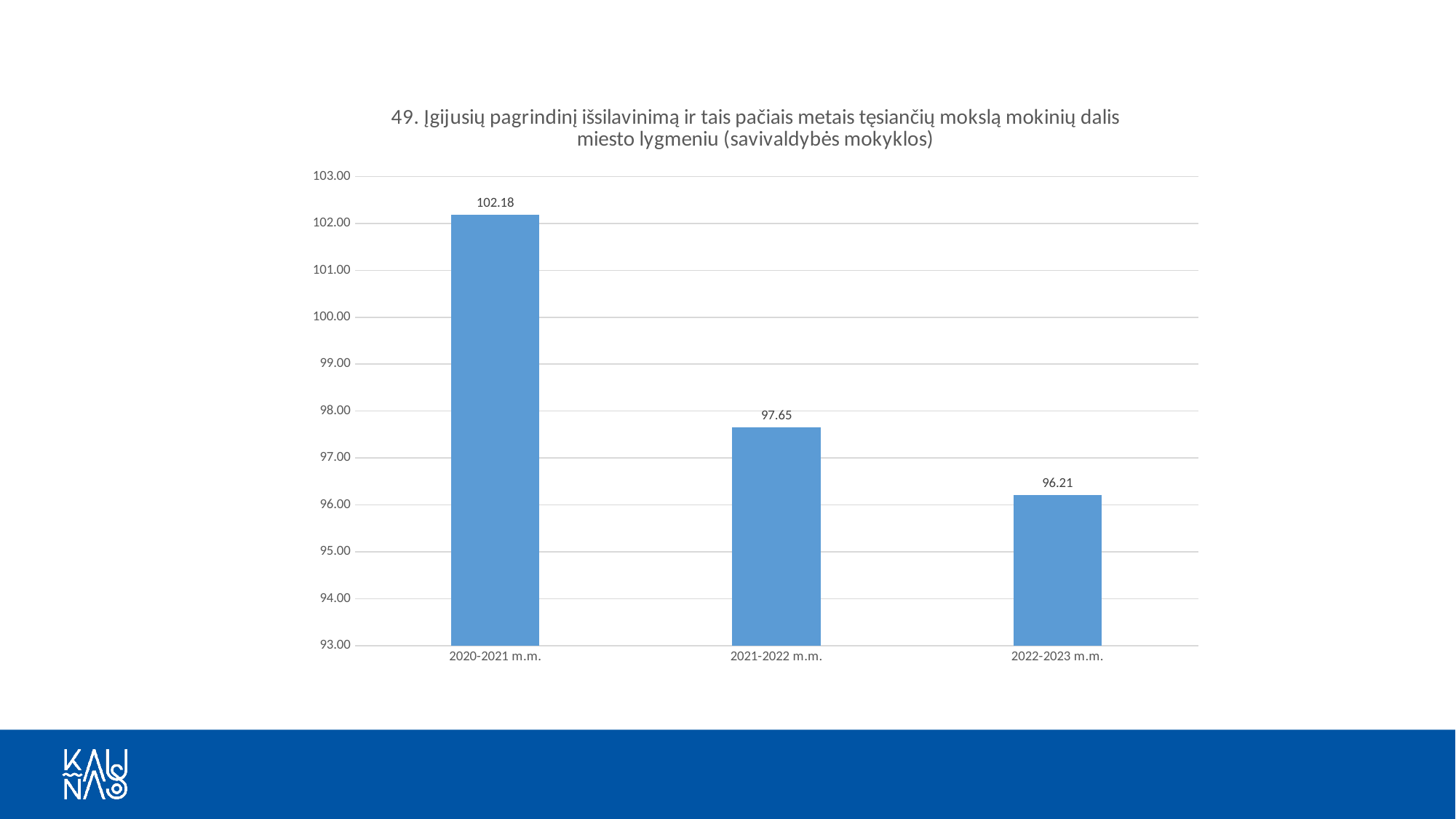
What is the difference between the values for 2021-2022 m.m. and 2022-2023 m.m.? 1.44 What is the difference between the values for 2020-2021 m.m. and 2021-2022 m.m.? 4.53 Which is larger, the value for 2021-2022 m.m. or 2022-2023 m.m.? 2021-2022 m.m. What is the value for 2022-2023 m.m.? 96.21 What is the value for 2021-2022 m.m.? 97.65 Which school year has the highest value? 2020-2021 m.m. Do the values rise or fall from 2020-2021 m.m. to 2022-2023 m.m.? fall What is the value for 2020-2021 m.m.? 102.18 What kind of chart is shown on the slide? bar chart How many school years are shown on the chart? 3 Which school year has the lowest value? 2022-2023 m.m. Is the value for 2020-2021 m.m. greater or less than 100.00? greater